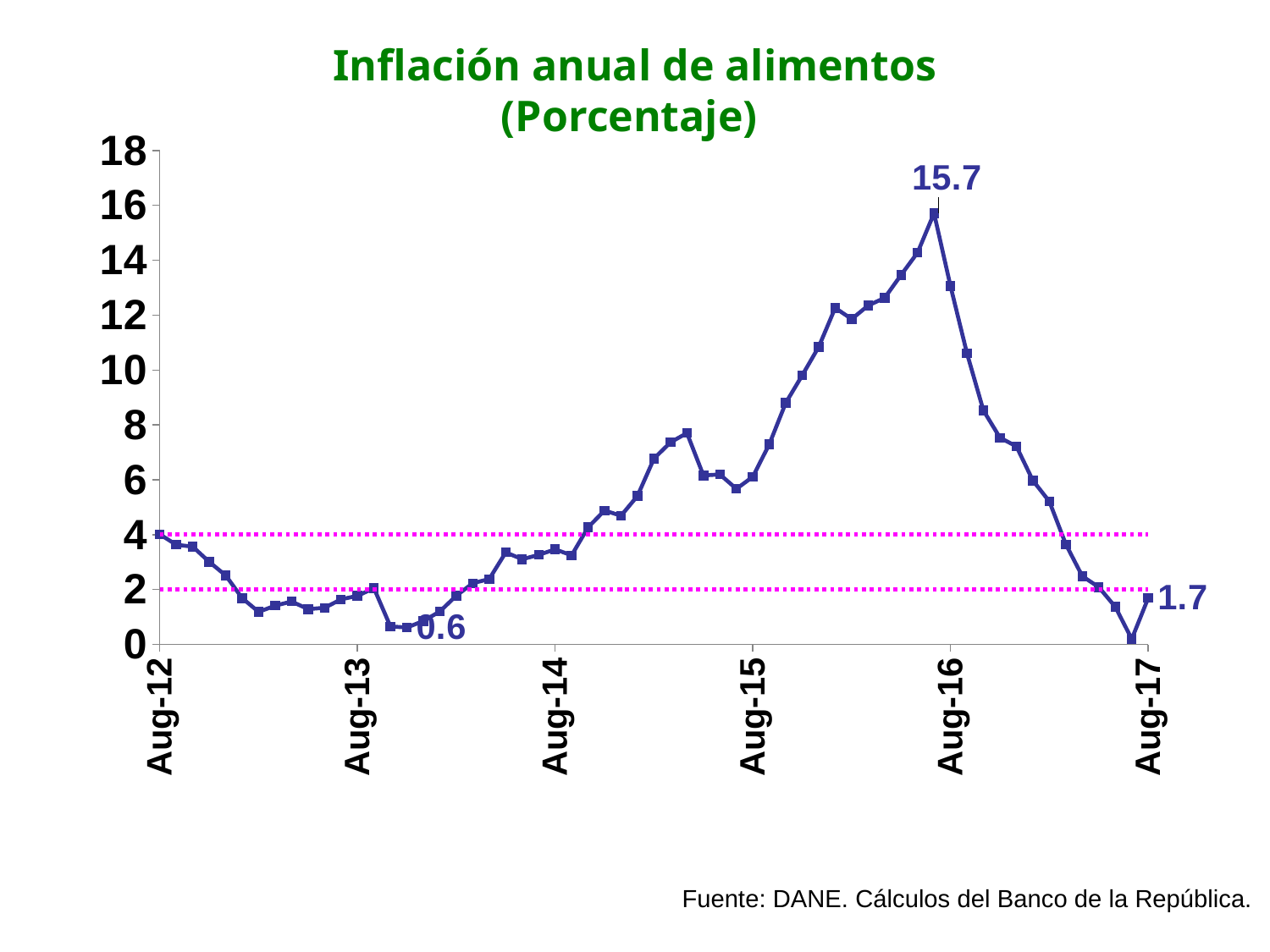
Which is larger, the value at Aug-16 or the value at Aug-17? Aug-16 Is the value at Aug-15 greater or less than 8? less What is the difference between the labelled peak (15.7) and the labelled low (0.6)? 15.1 What is the highest value labelled on the line? 15.7 What is the value of the last point, at Aug-17? 1.7 Does the line rise or fall between Aug-16 and Aug-17? fall Is the value at Aug-16 greater or less than 14? less What is the lowest value labelled on the line? 0.6 What is the difference between the peak value of 15.7 and the Aug-17 value of 1.7? 14 What is the title of the chart? Inflación anual de alimentos (Porcentaje) What kind of chart is shown on the slide? line chart Is the value at Aug-14 greater or less than 2? greater